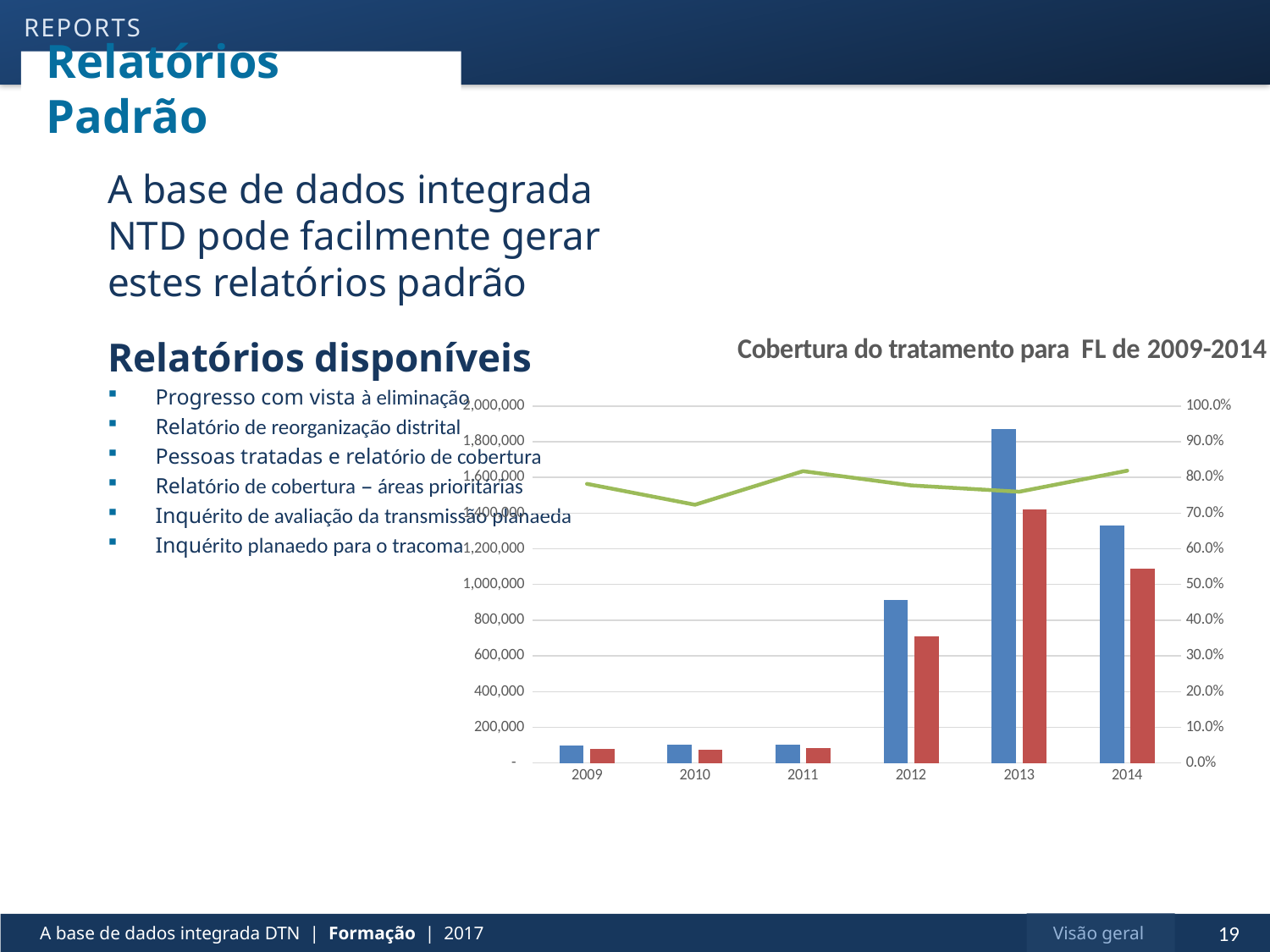
What kind of chart is shown on the slide? A combined bar and line chart Which is larger, the blue bar for 2013 or the blue bar for 2014? 2013 Is the red bar for 2012 greater or less than 800,000? less In which year is the blue bar the tallest? 2013 Is the red bar for 2013 greater or less than 1,200,000? greater What is the title of the chart? Cobertura do tratamento para FL de 2009-2014 Is the green line value for 2010 greater or less than 80.0%? less In which year is the red bar the tallest? 2013 How many years are shown on the x axis of the chart? 6 In which year does the green line reach its lowest point? 2010